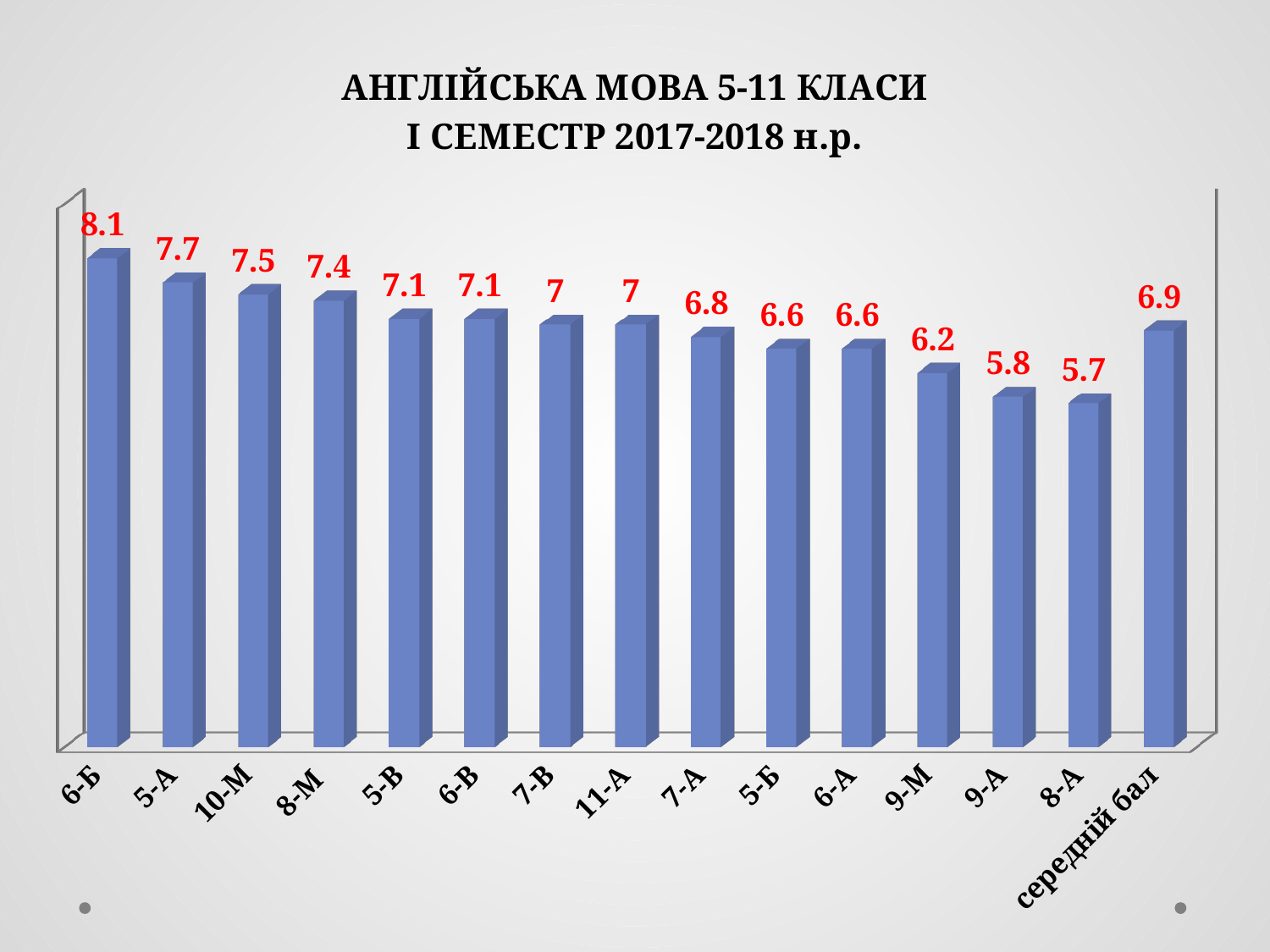
What kind of chart is shown on the slide? Bar chart Which class has the highest value? 6-Б What is the value for 6-Б? 8.1 What is the title of the chart? АНГЛІЙСЬКА МОВА 5-11 КЛАСИ І СЕМЕСТР 2017-2018 н.р. What is the difference between the values for 6-Б and 8-А? 2.4 What is the value shown for середній бал? 6.9 Which class has the lowest value? 8-А Which is larger, the value for 10-М or the value for 9-А? 10-М What is the difference between the values for 5-А and 7-А? 0.9 Which is larger, the value for 7-В or the value for 5-Б? 7-В How many bars are shown in the chart? 15 What is the value for 9-М? 6.2